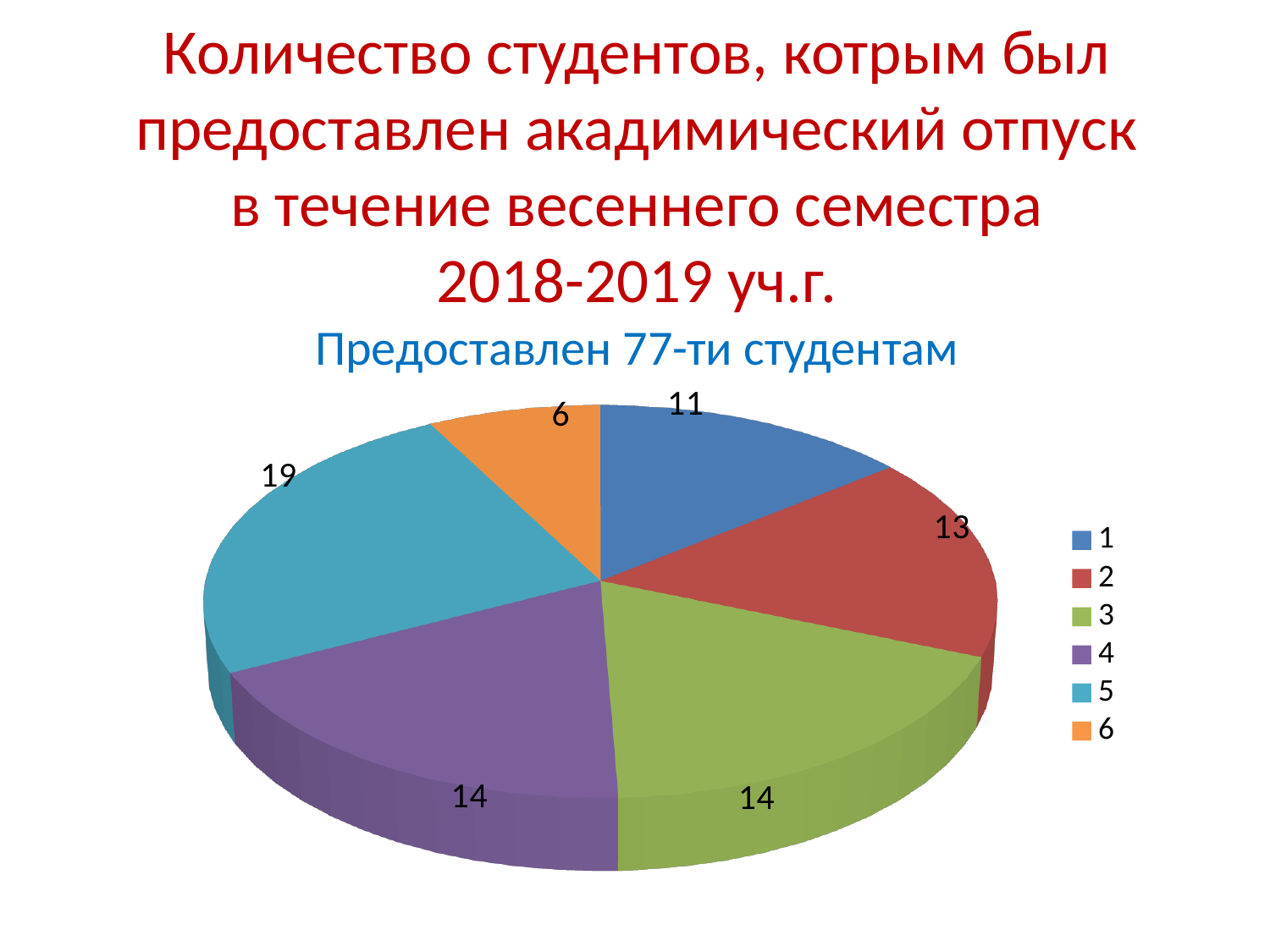
Which category has the largest slice in the pie chart? 5 Which category has the smallest slice in the pie chart? 6 Which is larger, the value for category 2 or the value for category 1? category 2 What kind of chart is shown on the slide? pie chart What is the difference between the values for category 5 and category 6? 13 What is the value for category 1 in the pie chart? 11 What is the difference between the values for category 2 and category 1? 2 What is the total number of students across all slices of the pie chart? 77 How many entries does the legend list? 6 How many slices does the pie chart have? 6 What is the value for category 6 in the pie chart? 6 What is the value for category 5 in the pie chart? 19